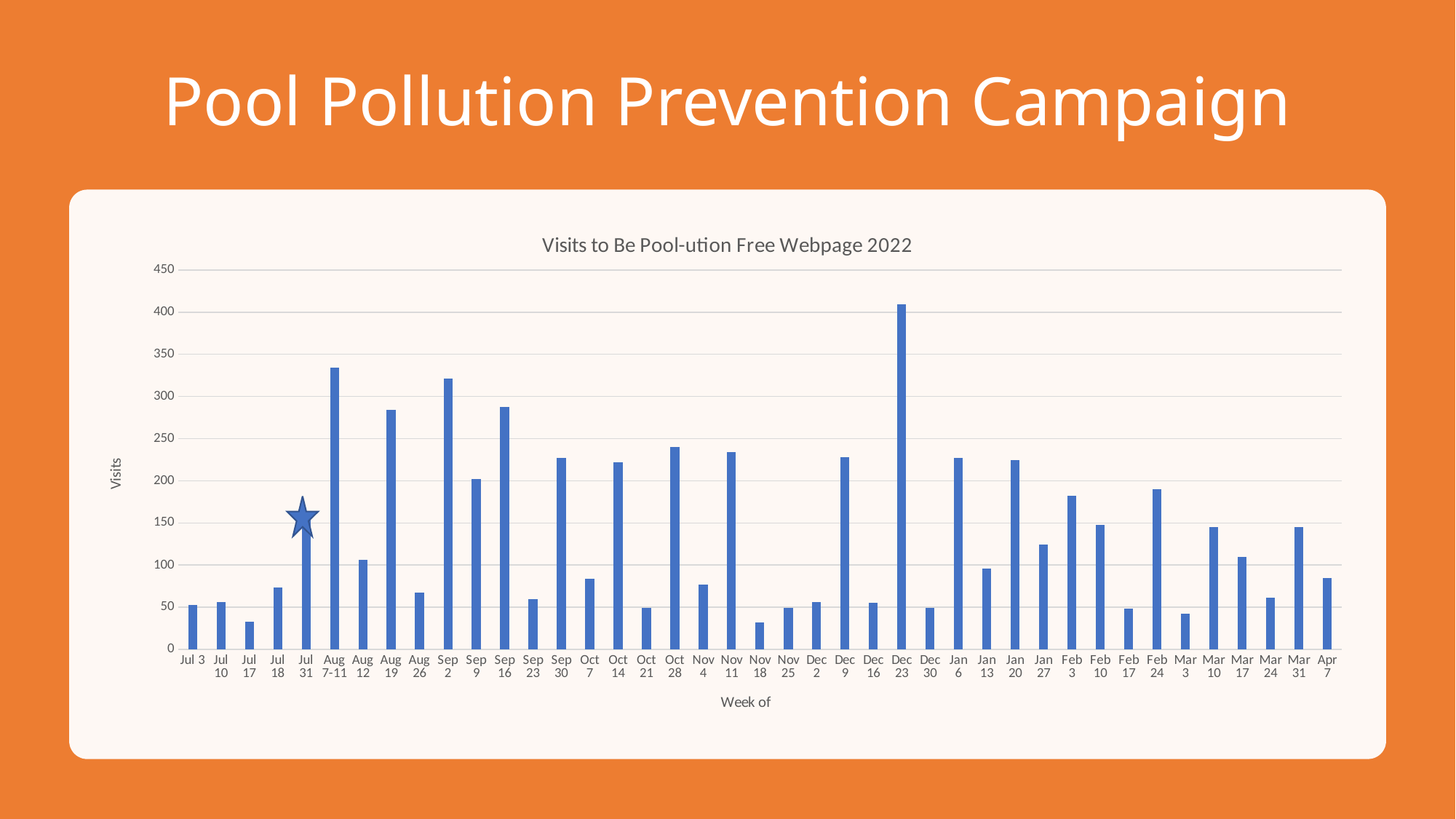
How many weeks are plotted on the x axis? 41 Is the value for Feb 24 greater or less than 200? less Which week has more visits, Oct 21 or Oct 28? Oct 28 Is the value for Aug 7-11 greater or less than 300? greater Is the value for Aug 19 greater or less than 300? less Which week has more visits, Aug 7-11 or Aug 19? Aug 7-11 Which week has the highest number of visits? Dec 23 What type of chart is shown on the slide? bar chart What is the title of the chart? Visits to Be Pool-ution Free Webpage 2022 What is the label of the vertical axis? Visits